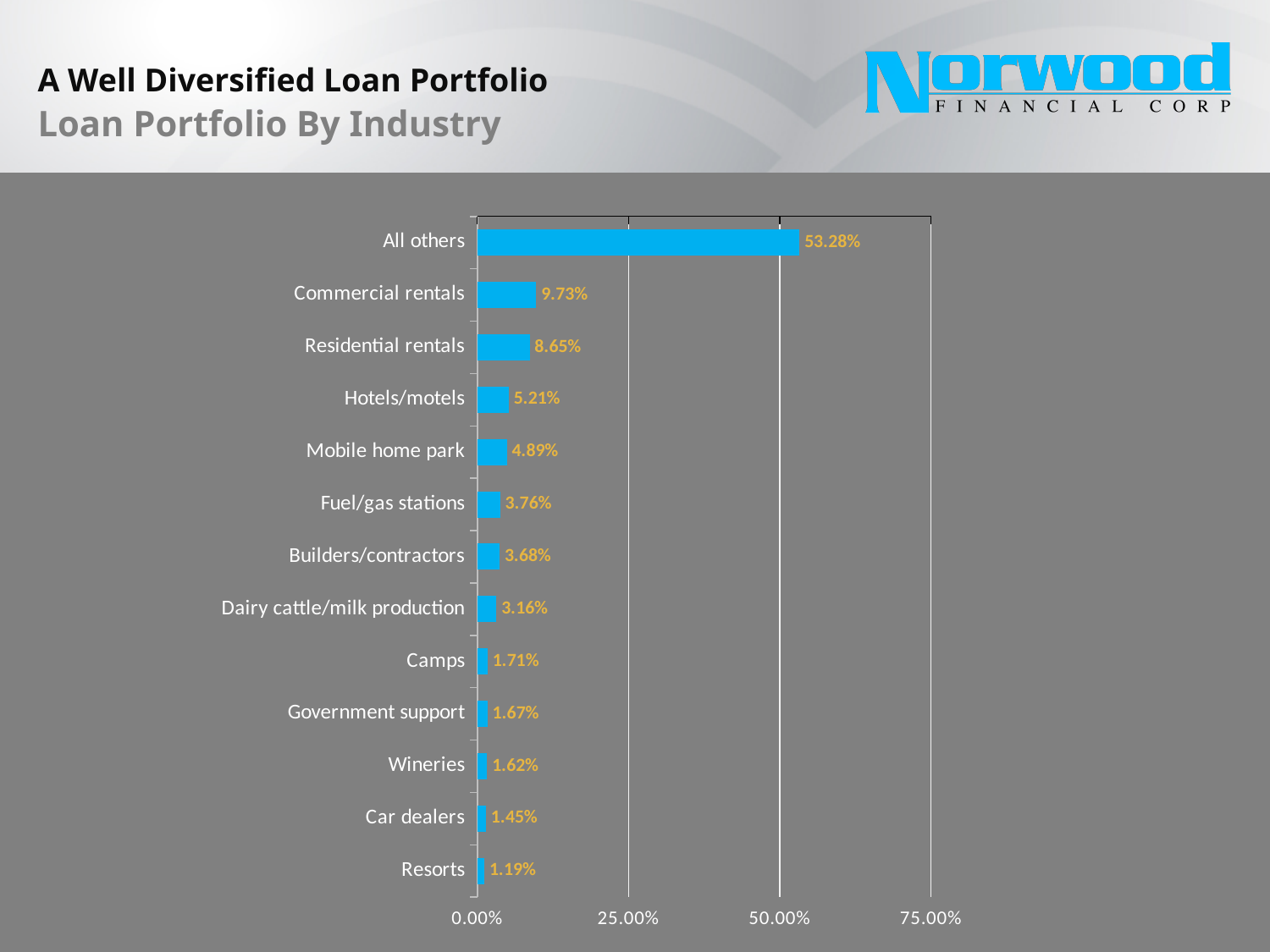
What kind of chart is shown on the slide? Bar chart Which category has the lowest value? Resorts Which is larger, Mobile home park or Fuel/gas stations? Mobile home park How many categories are shown in the chart? 13 What is the value for Dairy cattle/milk production? 3.16% What is the difference between Commercial rentals and Residential rentals? 1.08% What is the value for Commercial rentals? 9.73% What is the value for Resorts? 1.19% What is the value for Hotels/motels? 5.21% What is the subtitle of the chart on the slide? Loan Portfolio By Industry Is the value for All others greater or less than 50.00%? greater Which category has the highest value? All others